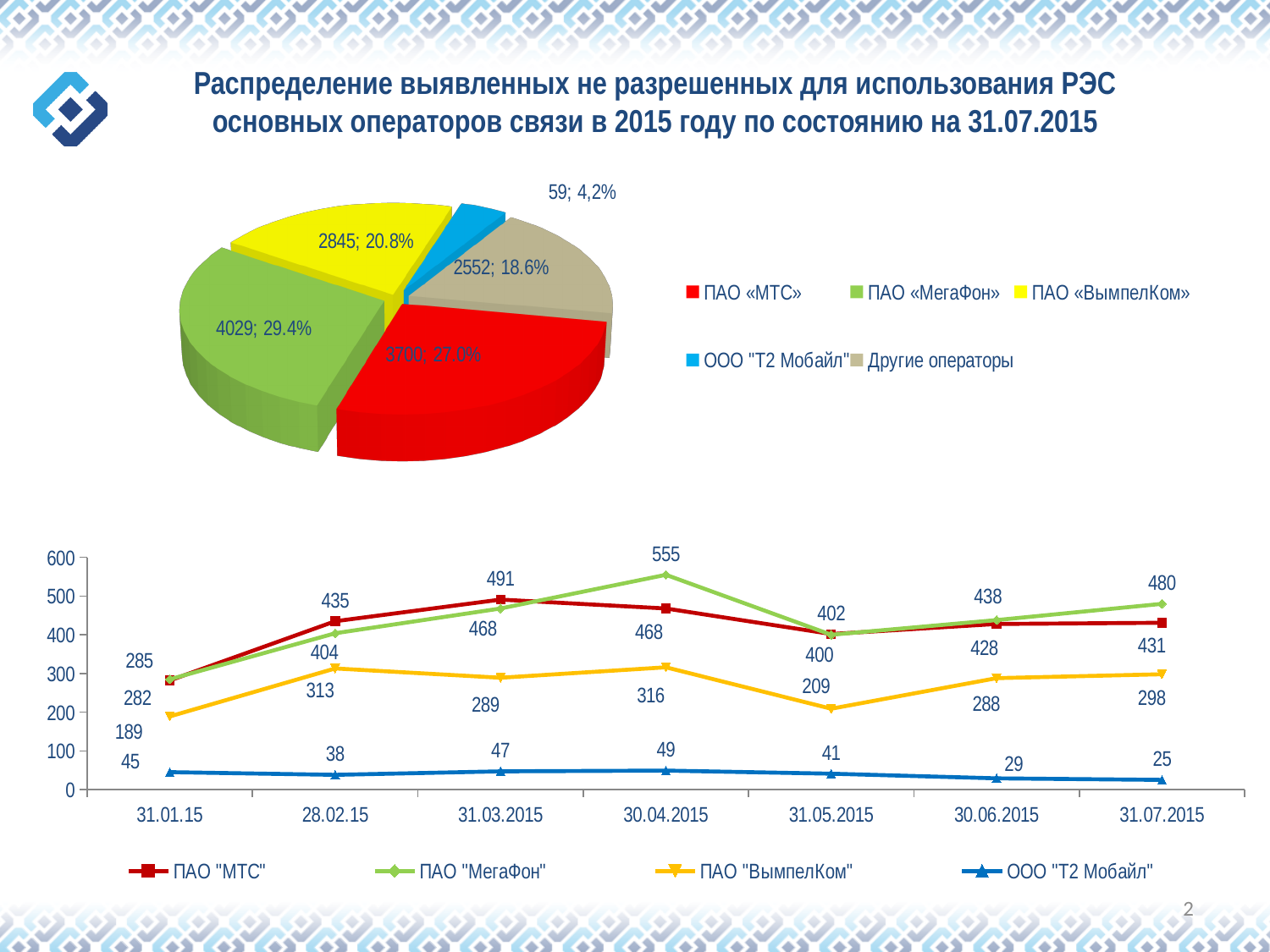
In the line chart, which is larger on 31.07.2015: ПАО "МегаФон" or ПАО "МТС"? ПАО "МегаФон" In the line chart, what is the value for ПАО "МегаФон" on 30.04.2015? 555 How many slices does the pie chart have? 5 What type of chart is the bottom chart on the slide? Line chart In the line chart, how many dates are shown on the x axis? 7 In the line chart, what is the value for ООО "Т2 Мобайл" on 31.07.2015? 25 In the line chart, how many series does the legend list? 4 In the pie chart, what value and share are shown for ПАО «МегаФон»? 4029; 29.4% In the pie chart, which operator has the largest slice? ПАО «МегаФон» In the pie chart, which operator has the smallest slice? ООО "Т2 Мобайл" In the line chart, what is the difference between ПАО "МТС" and ПАО "МегаФон" on 28.02.15? 31 In the pie chart, what share is shown for Другие операторы? 18.6%